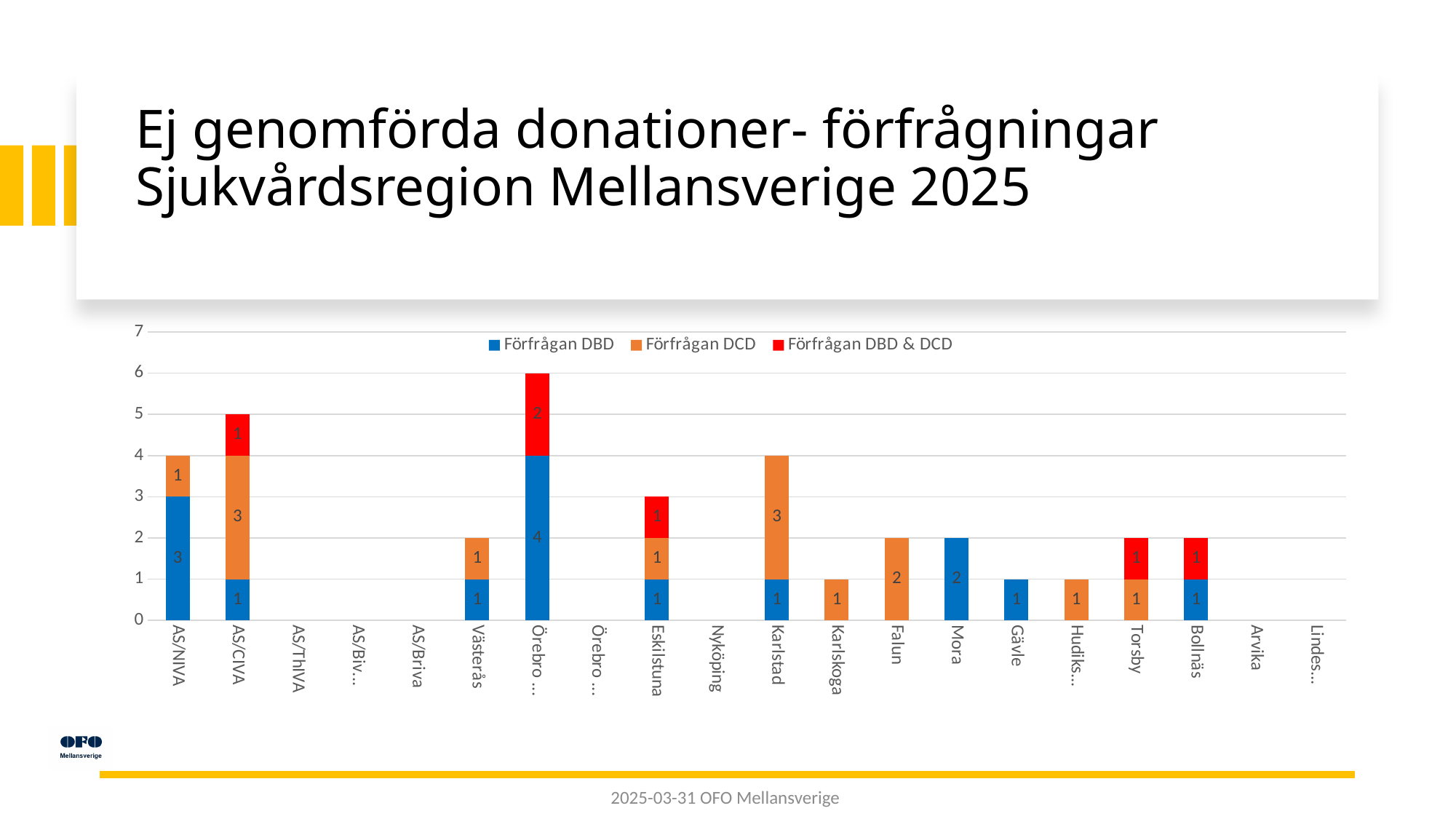
What is the total of the tallest stacked bar in the chart? 6 Which is larger, the Förfrågan DBD value for Mora or the Förfrågan DBD value for Gävle? Mora What is the difference between the Förfrågan DCD values for Karlstad and Falun? 1 What is the Förfrågan DCD value for Karlstad? 3 What type of chart is shown on the slide? Stacked bar chart What is the total of the stacked bar for AS/CIVA? 5 How many categories are shown on the x axis? 20 Which colour represents Förfrågan DBD & DCD in the legend? Red What is the Förfrågan DBD value for AS/NIVA? 3 What is the total of the stacked bar for Eskilstuna? 3 What is the Förfrågan DBD & DCD value for AS/CIVA? 1 How many series does the legend list? 3